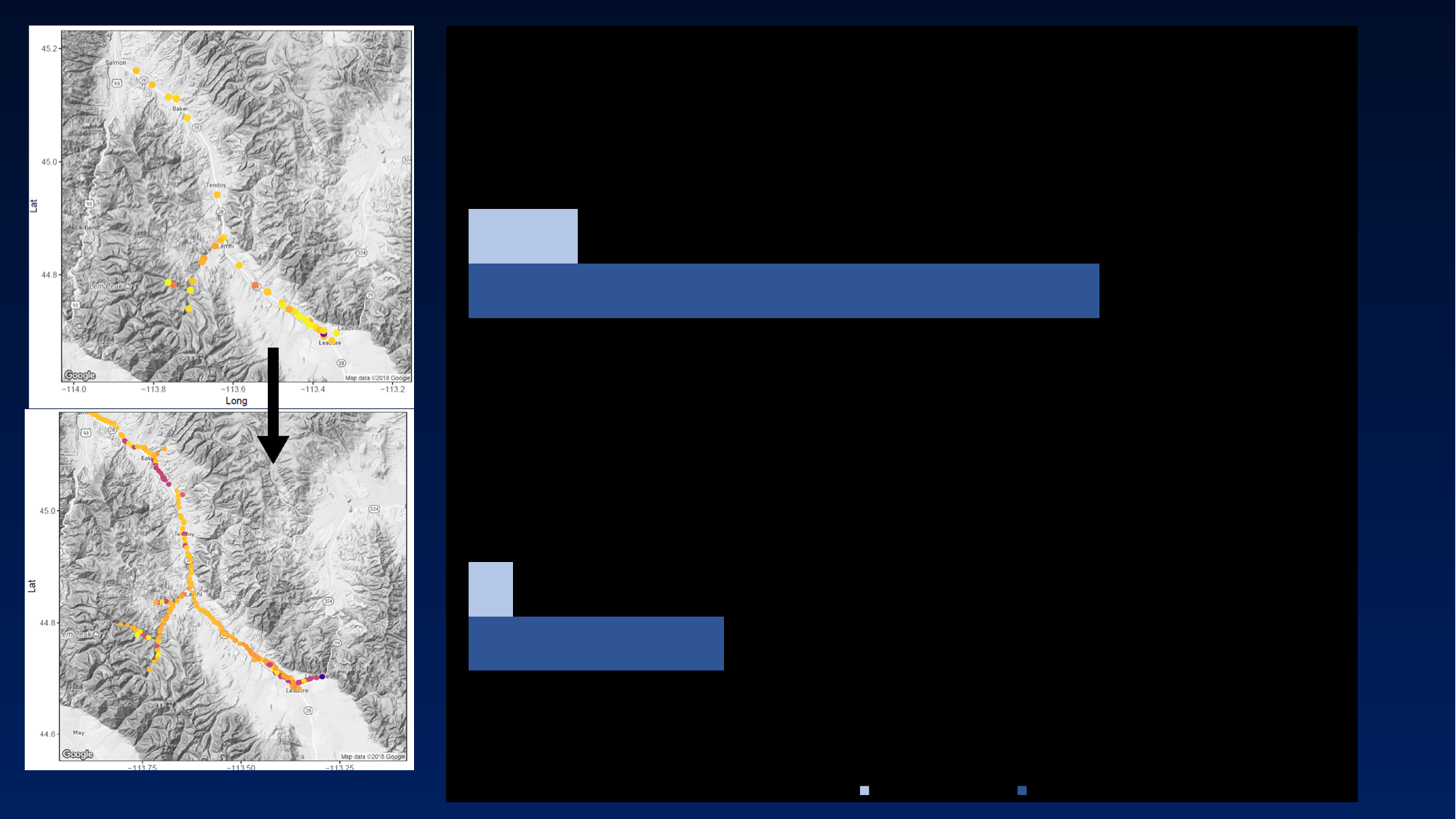
In the bar chart on the right, which single bar is the longest of all four? the dark blue bar in the upper group What kind of chart is shown on the right side of the slide? bar chart What two colours are used for the bars in the chart on the right? light blue and dark blue In the bar chart on the right, how many bars are plotted in total? 4 In the bar chart on the right, which bar is the longest: the light blue or the dark blue bar in the upper group? the dark blue bar In the bar chart on the right, in the lower group, is the light blue bar or the dark blue bar longer? the dark blue bar In the bar chart on the right, which single bar is the shortest of all four? the light blue bar in the lower group In the bar chart on the right, is the dark blue bar in the upper group longer or shorter than the dark blue bar in the lower group? longer How many category groups of bars are plotted in the bar chart on the right? 2 How many series does the legend of the bar chart on the right list? 2 In the bar chart on the right, are the bars drawn horizontally or vertically? horizontally